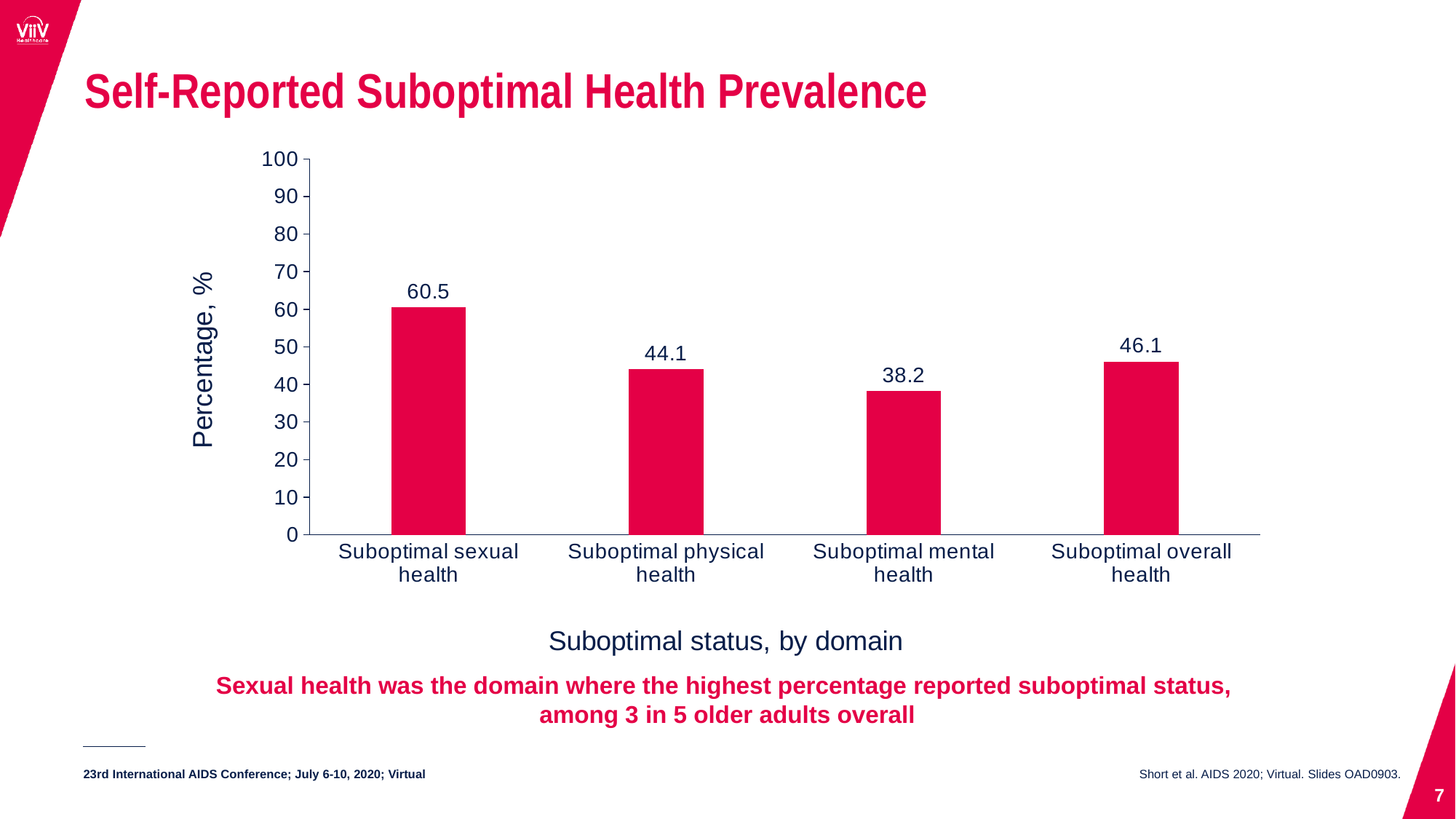
What is the label of the vertical axis? Percentage, % What is the percentage reporting suboptimal sexual health? 60.5 What is the percentage reporting suboptimal mental health? 38.2 What is the percentage reporting suboptimal overall health? 46.1 Which domain has the lowest percentage reporting suboptimal status? Suboptimal mental health Is the value for suboptimal sexual health greater or less than 50? greater Which domain has the highest percentage reporting suboptimal status? Suboptimal sexual health How many domains are shown on the chart? 4 What is the percentage reporting suboptimal physical health? 44.1 What is the difference in percentage between suboptimal sexual health and suboptimal mental health? 22.3 What kind of chart is shown on the slide? Bar chart Which is larger: the percentage for suboptimal overall health or suboptimal physical health? Suboptimal overall health